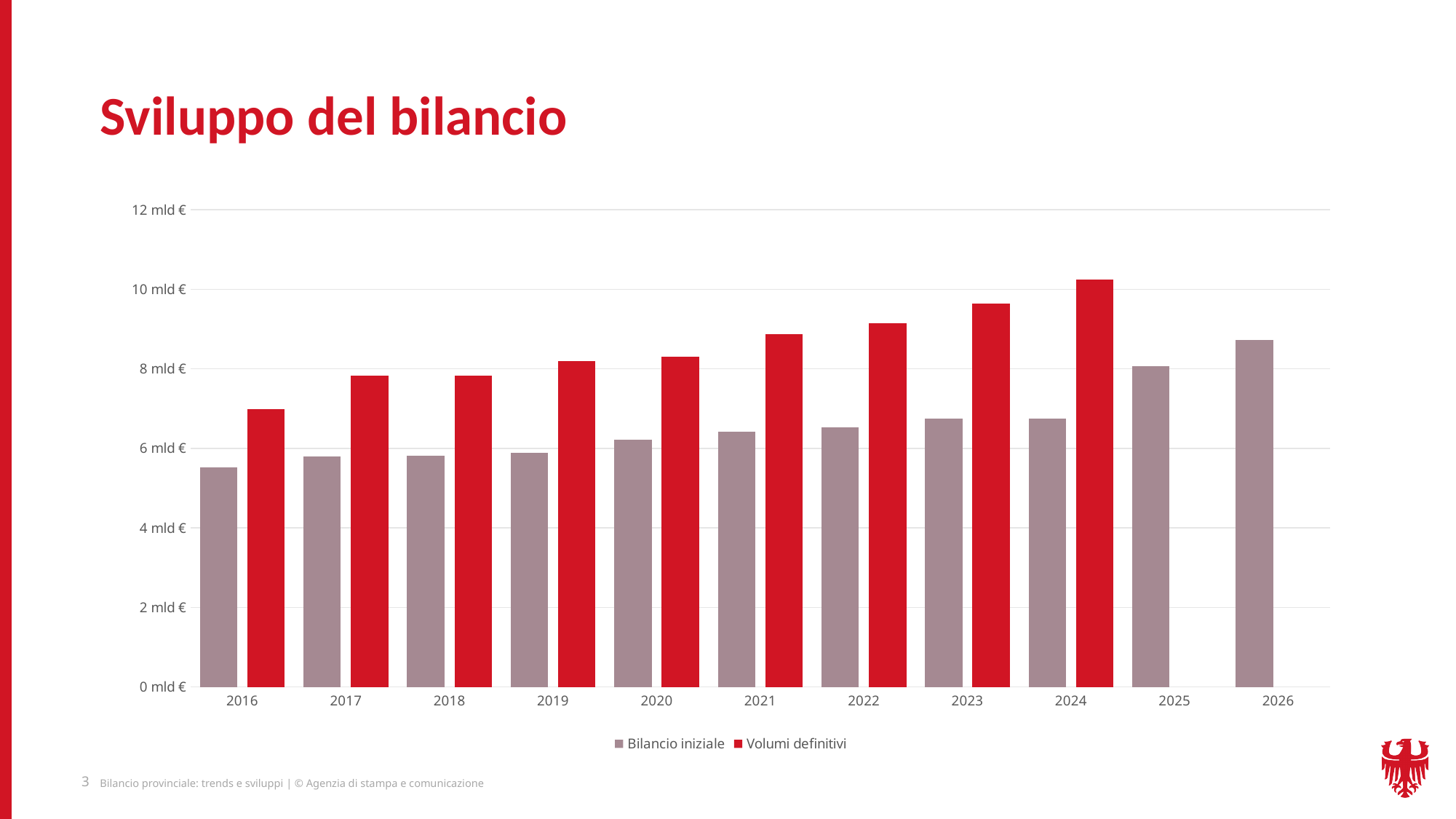
Does the Bilancio iniziale series generally rise or fall from 2016 to 2026? rise Which is larger in 2024, Bilancio iniziale or Volumi definitivi? Volumi definitivi Is the Volumi definitivi value for 2021 greater or less than 8 mld €? greater What is the title of the chart? Sviluppo del bilancio How many series does the legend list? 2 Is the Bilancio iniziale value for 2016 greater or less than 6 mld €? less Is the Bilancio iniziale value for 2026 greater or less than 8 mld €? greater What kind of chart is shown on the slide? bar chart In which year is the Volumi definitivi value highest? 2024 In which year is the Bilancio iniziale value highest? 2026 In which year is the Bilancio iniziale value lowest? 2016 How many years are shown on the x axis? 11